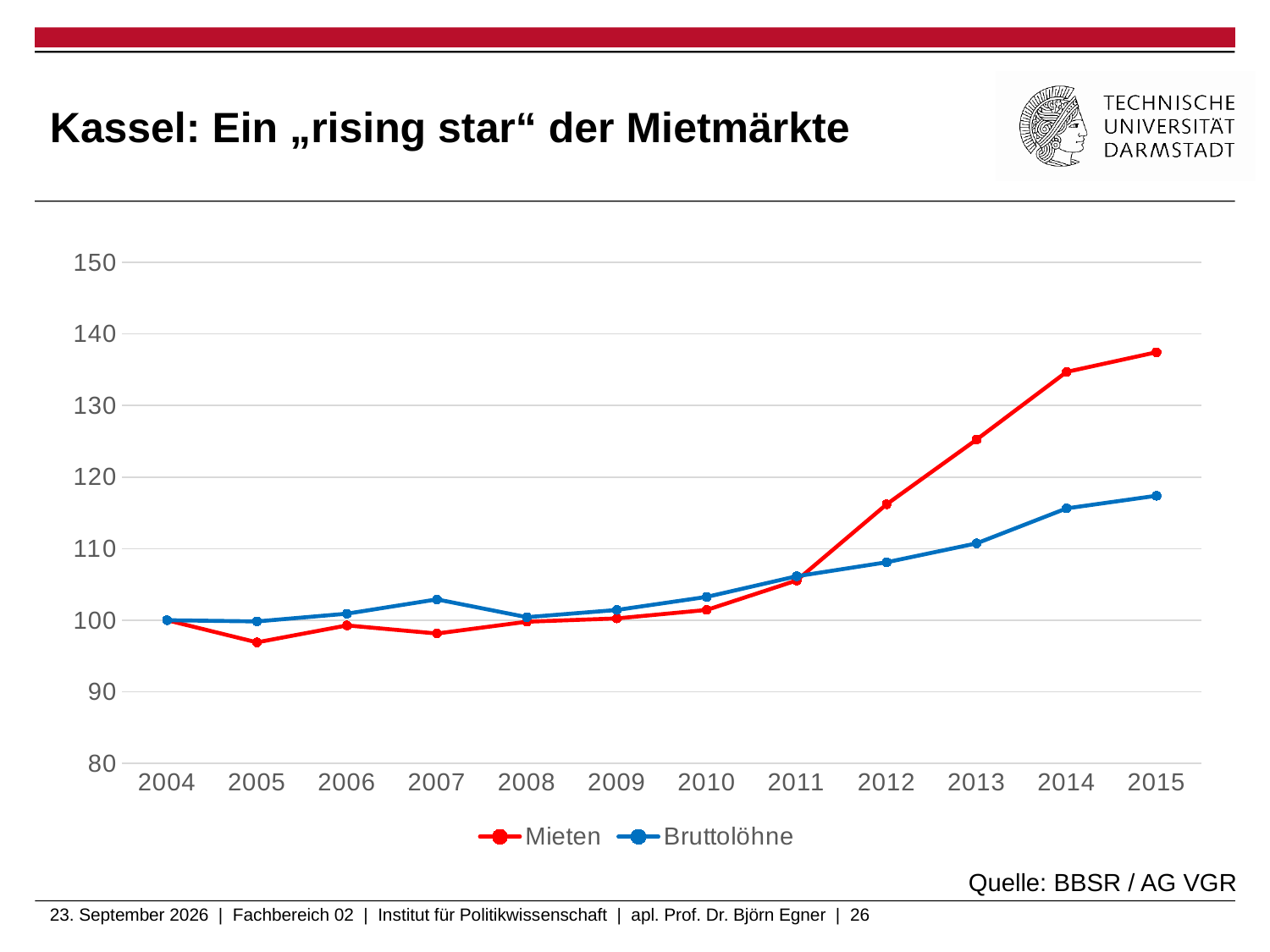
Is the value for Bruttolöhne in 2015 greater or less than 120? less How many years are plotted along the x axis? 12 How many series does the legend list? 2 Is the value for Mieten in 2005 greater or less than 100? less Which series has the higher value in 2015, Mieten or Bruttolöhne? Mieten In which year does the Mieten series reach its highest value? 2015 Which series has the higher value in 2007, Mieten or Bruttolöhne? Bruttolöhne Do the values for Mieten rise or fall between 2011 and 2015? rise Is the value for Mieten in 2015 greater or less than 130? greater In which year does the Mieten series reach its lowest value? 2005 What is the value for Mieten in 2004? 100 What kind of chart is shown on the slide? line chart